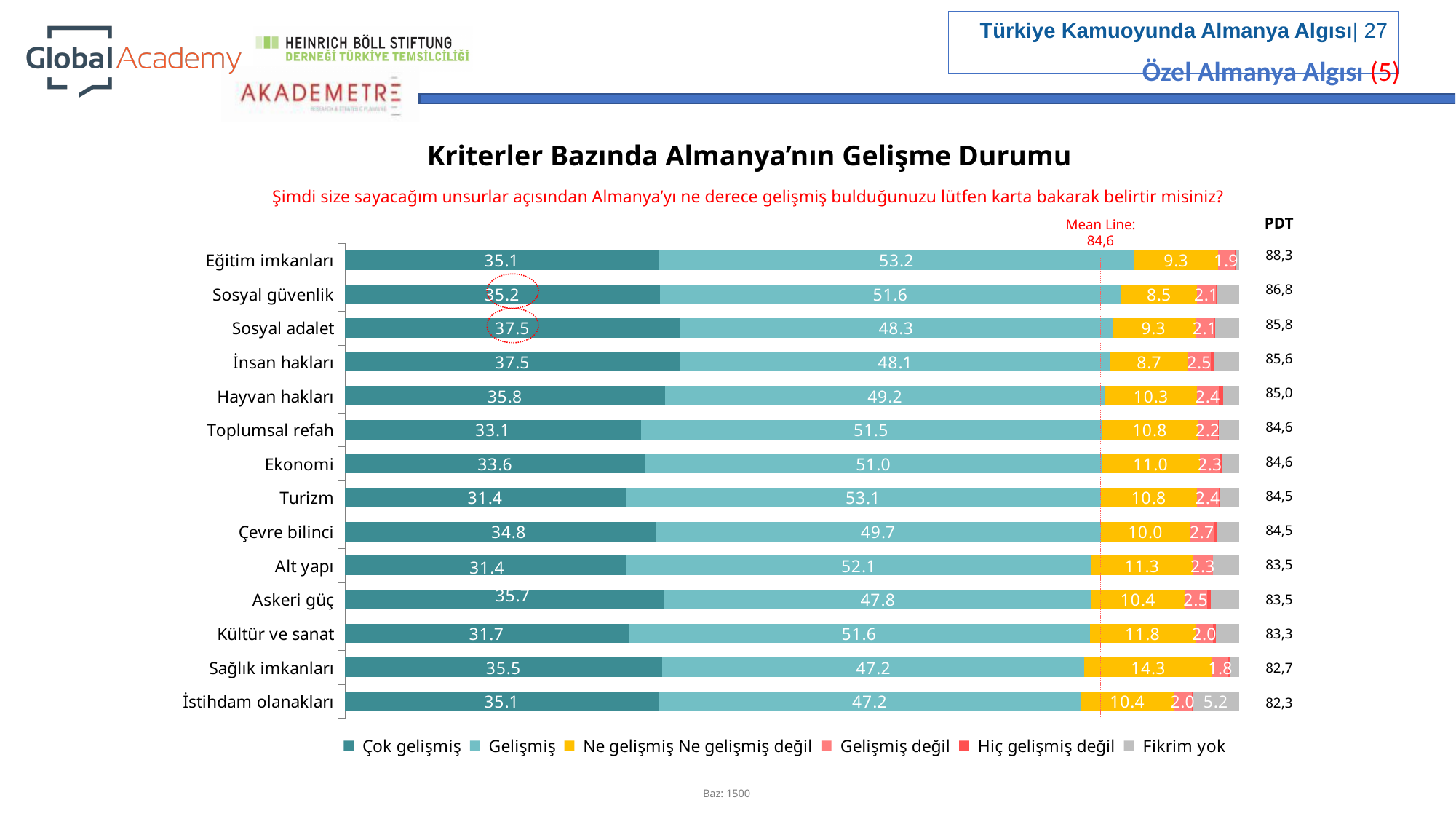
What is the 'Ne gelişmiş Ne gelişmiş değil' value for Sağlık imkanları? 14.3 What is the title of the chart? Kriterler Bazında Almanya'nın Gelişme Durumu Which has the larger 'Ne gelişmiş Ne gelişmiş değil' value, Ekonomi or Hayvan hakları? Ekonomi What is the 'Gelişmiş' value for Eğitim imkanları? 53.2 Which category has the highest 'Ne gelişmiş Ne gelişmiş değil' value? Sağlık imkanları What is the 'Fikrim yok' value for İstihdam olanakları? 5.2 How many series does the legend list? 6 What is the difference between the 'Çok gelişmiş' values for Sosyal adalet and Toplumsal refah? 4.4 How many categories (criteria) are plotted in the chart? 14 What is the 'Çok gelişmiş' value for Sosyal adalet? 37.5 What kind of chart is shown on the slide? bar chart What is the value of the Mean Line shown on the chart? 84,6